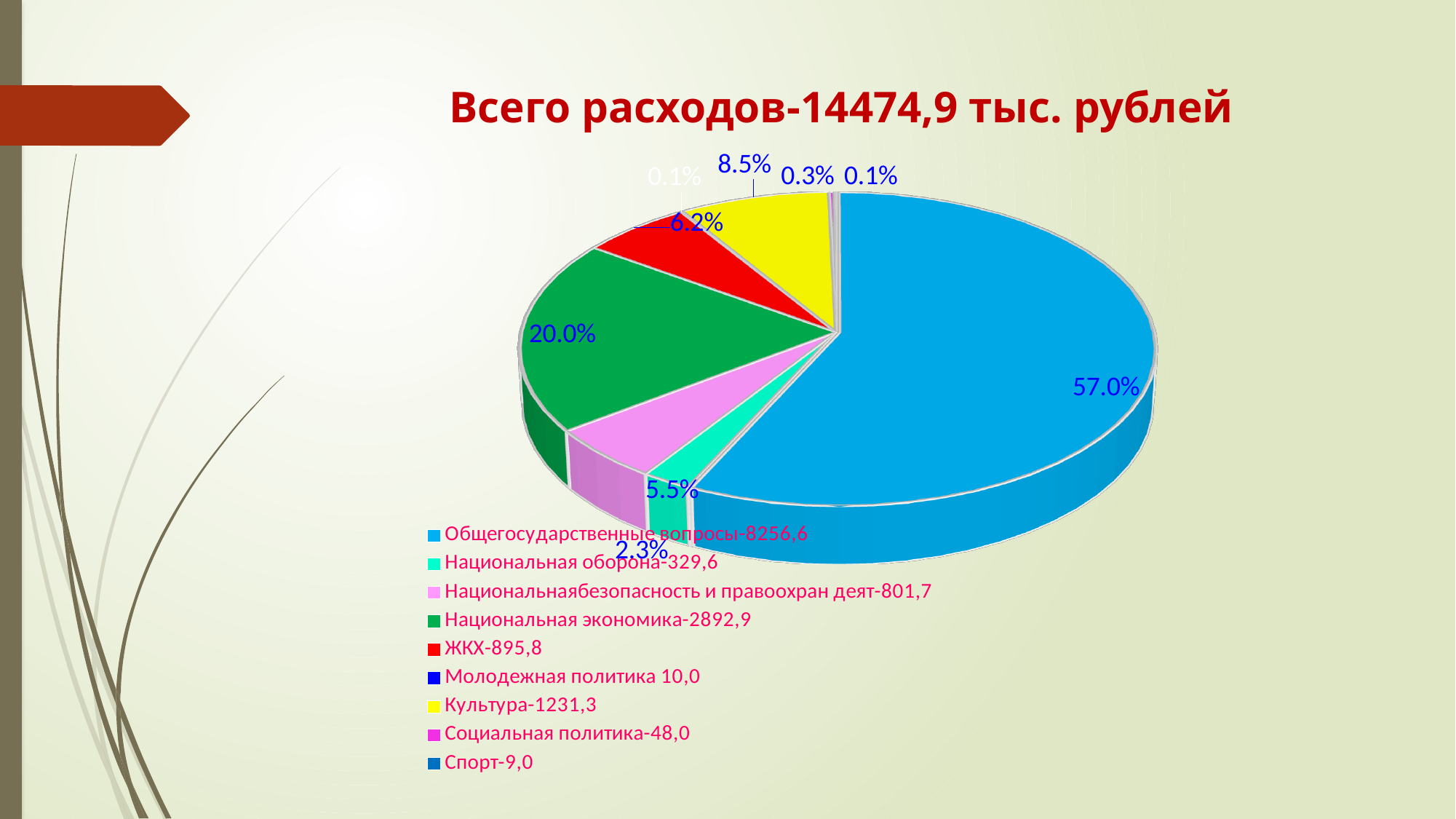
How many categories does the legend list? 9 What share of the pie does Культура take? 8.5% What value is given for Национальная экономика in the legend? 2892,9 What share of the pie does Общегосударственные вопросы take? 57.0% What share of the pie does Национальная оборона take? 2.3% What is the title of the chart? Всего расходов-14474,9 тыс. рублей Which slice is larger: Национальная экономика or Культура? Национальная экономика What kind of chart is shown on the slide? pie chart What is the difference in percentage points between the Общегосударственные вопросы slice and the Национальная экономика slice? 37.0% Which category has the largest slice of the pie? Общегосударственные вопросы